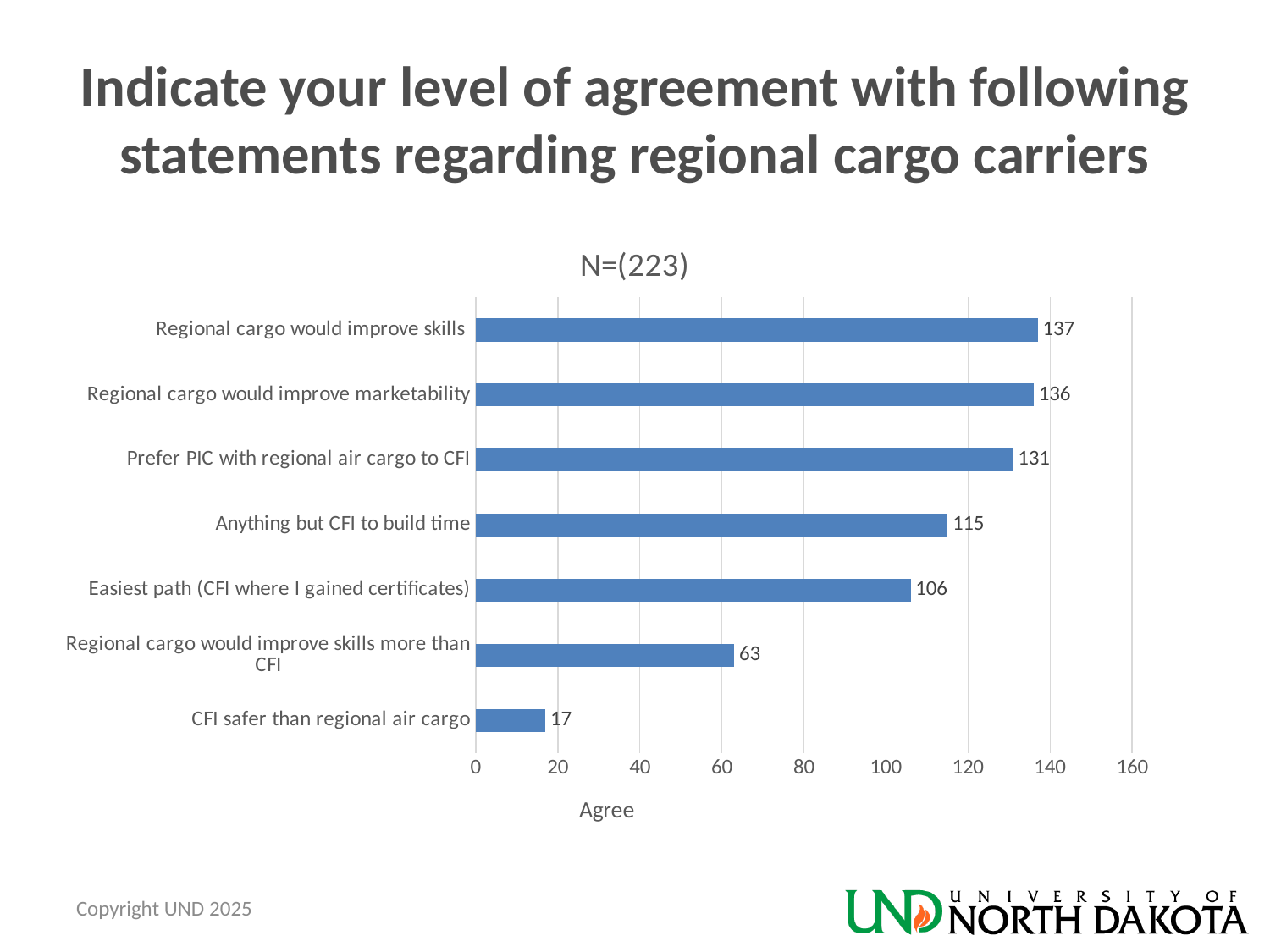
What is the value for "Regional cargo would improve skills"? 137 How many categories are shown in the chart? 7 What is the chart's title? N=(223) What is the value for "Easiest path (CFI where I gained certificates)"? 106 What is the value for "Anything but CFI to build time"? 115 What is the value for "CFI safer than regional air cargo"? 17 What is the difference between "Prefer PIC with regional air cargo to CFI" and "Regional cargo would improve skills more than CFI"? 68 Which is larger: "Anything but CFI to build time" or "Easiest path (CFI where I gained certificates)"? Anything but CFI to build time Which category has the lowest value? CFI safer than regional air cargo Is the value for "Regional cargo would improve marketability" greater or less than 120? greater What is the x-axis label of the chart? Agree What kind of chart is shown on the slide? Bar chart